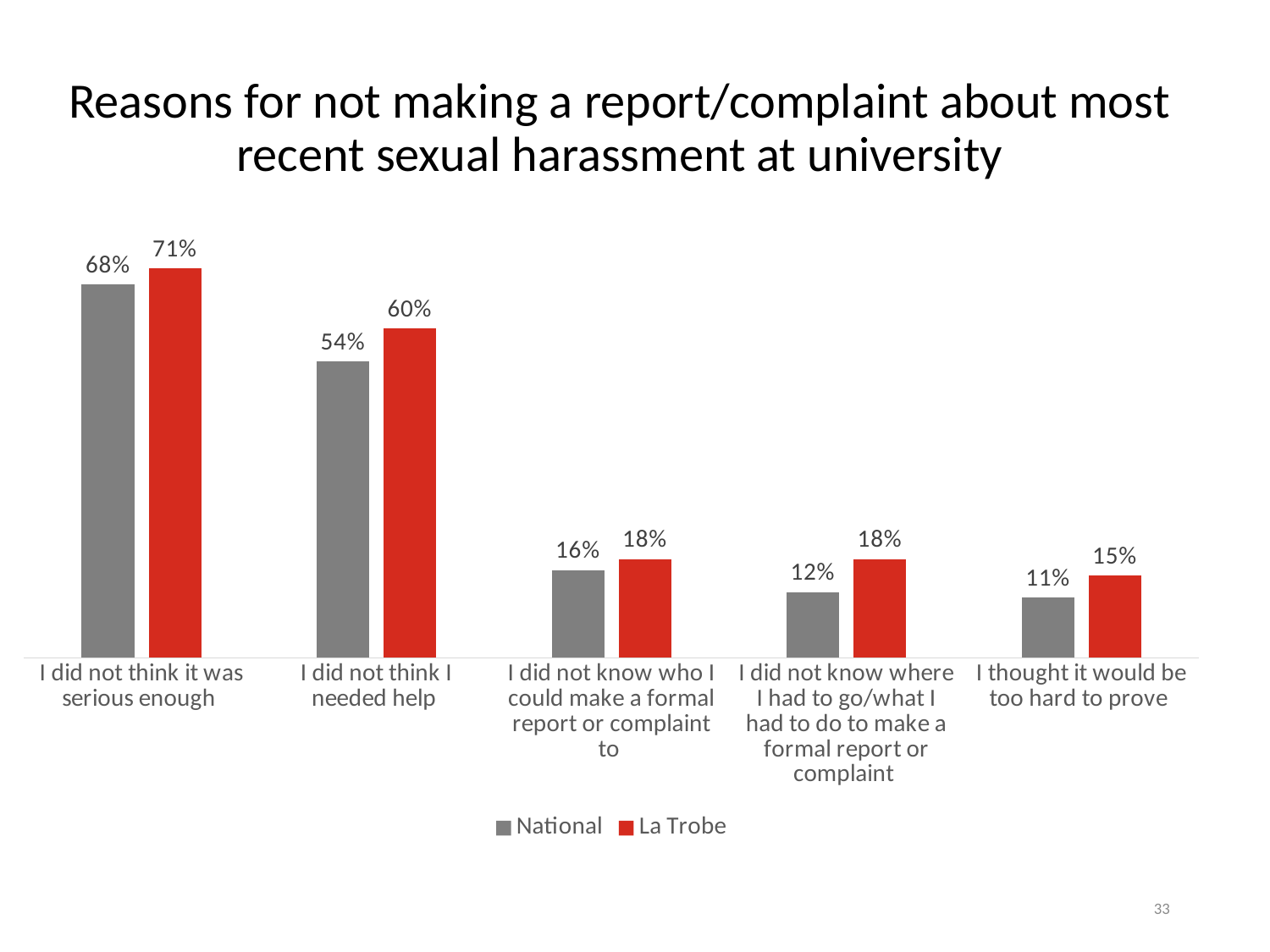
How many series does the legend list? 2 Which category has the lowest National value? I thought it would be too hard to prove Which is larger for "I did not know who I could make a formal report or complaint to": the National value or the La Trobe value? La Trobe What kind of chart is shown on the slide? Bar chart What is the National value for "I did not think it was serious enough"? 68% Which colour represents the La Trobe series? Red What is the National value for "I thought it would be too hard to prove"? 11% What is the La Trobe value for "I did not know where I had to go/what I had to do to make a formal report or complaint"? 18% What is the La Trobe value for "I did not think I needed help"? 60% How many categories are shown on the x axis? 5 What is the difference between the La Trobe and National values for "I did not think I needed help"? 6% Which category has the highest La Trobe value? I did not think it was serious enough